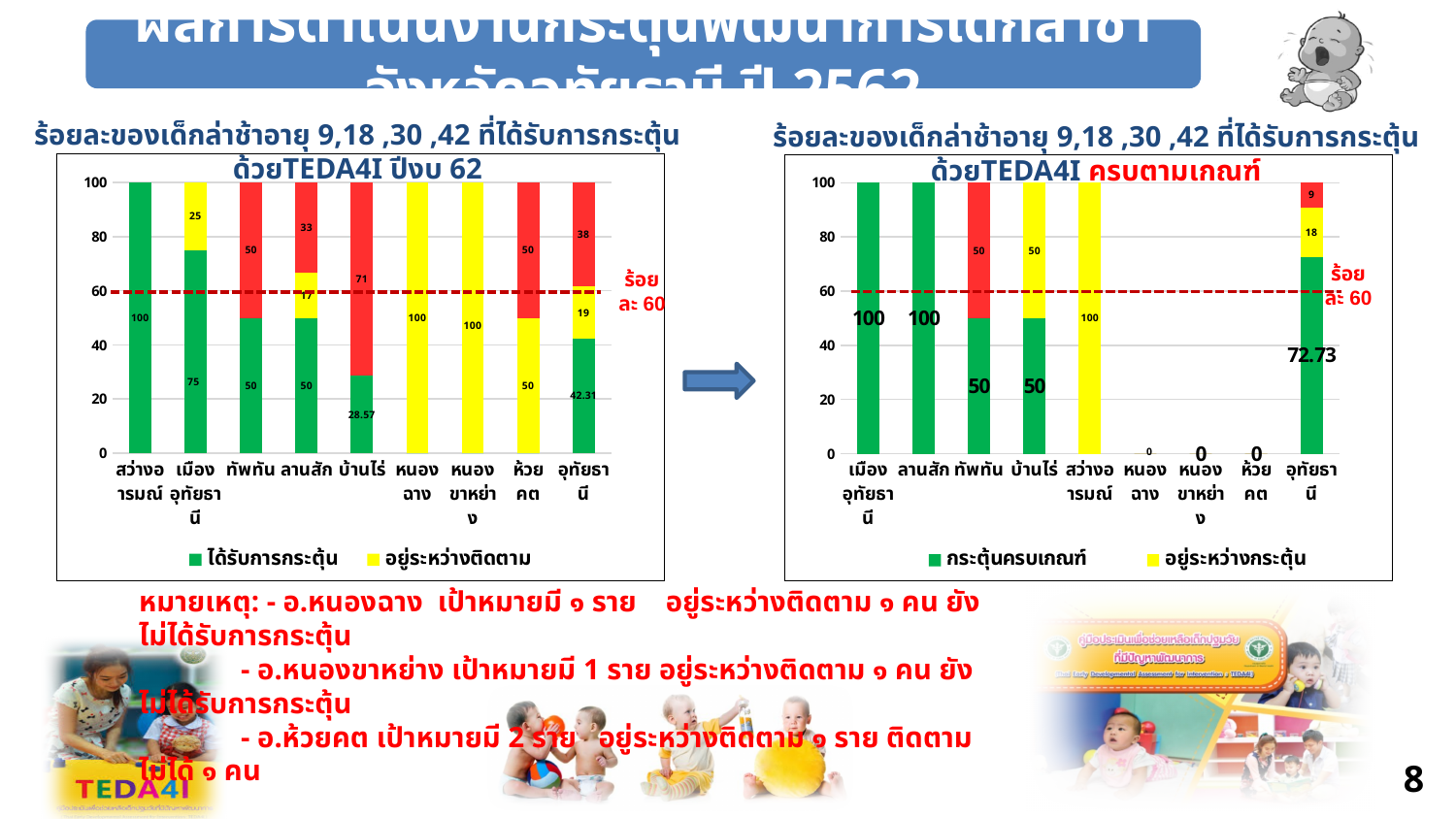
In the right chart (ครบตามเกณฑ์), which is larger, the green value for ลานสัก or the green value for ทัพทัน? ลานสัก In the left chart (ปีงบ 62), what is the green value for บ้านไร่? 28.57 In the right chart (ครบตามเกณฑ์), what is the green value for อุทัยธานี? 72.73 In the left chart (ปีงบ 62), what is the yellow (อยู่ระหว่างติดตาม) value for หนองฉาง? 100 In the right chart (ครบตามเกณฑ์), what is the difference between the green value for อุทัยธานี and the green value for ทัพทัน? 22.73 In the right chart (ครบตามเกณฑ์), what is the value shown for ห้วยคต? 0 In the right chart (ครบตามเกณฑ์), what is the yellow value for สว่างอารมณ์? 100 In the left chart (ปีงบ 62), what is the green value for สว่างอารมณ์? 100 In the left chart (ปีงบ 62), how many districts are shown on the x axis? 9 In the left chart (ปีงบ 62), what is the green (ได้รับการกระตุ้น) value for เมืองอุทัยธานี? 75 In the left chart (ปีงบ 62), what is the green value for อุทัยธานี? 42.31 What kind of chart is used on the left side of the slide? Stacked bar chart